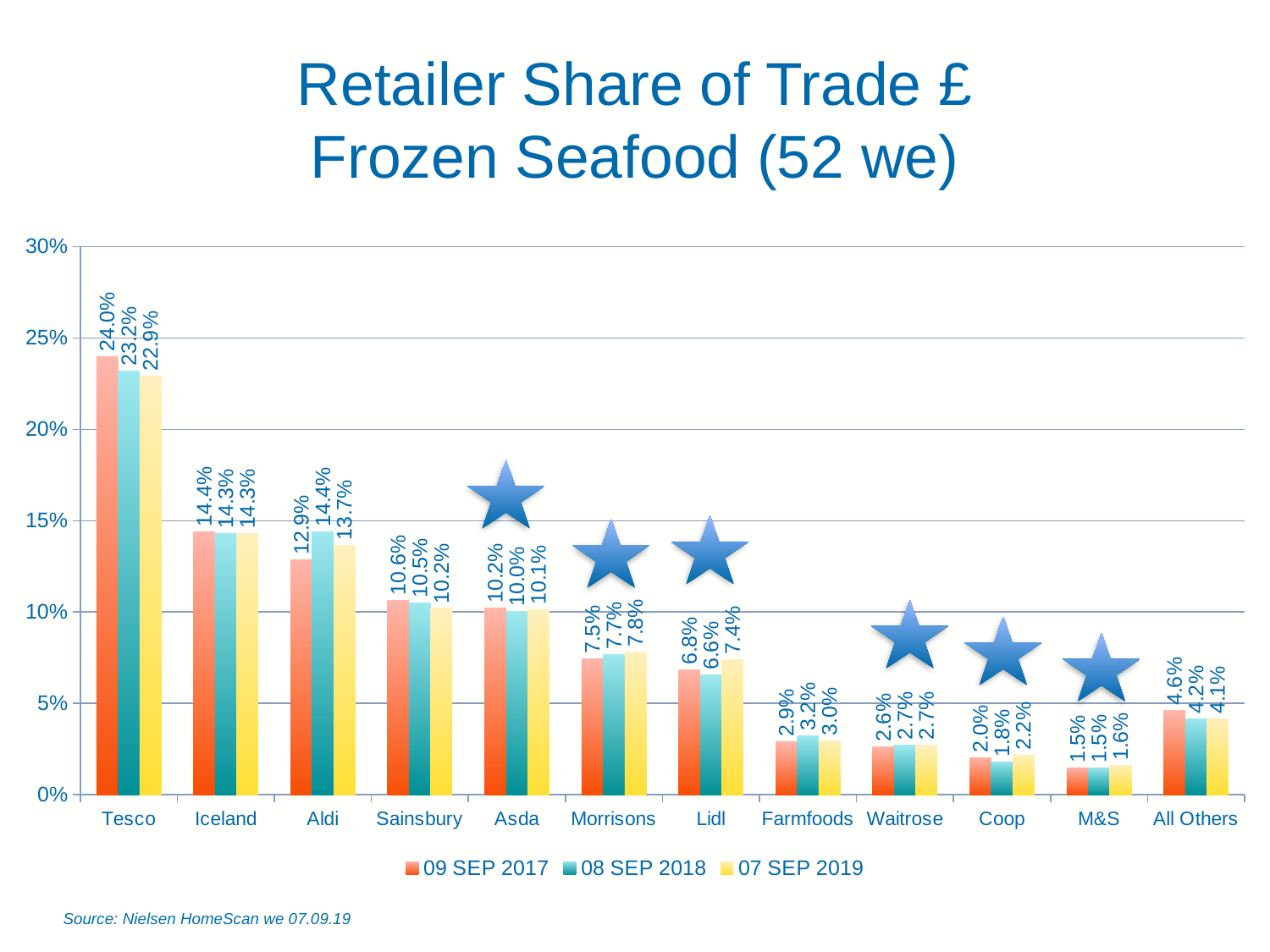
What is Tesco's share of trade for 07 SEP 2019? 22.9% What kind of chart is shown on the slide? Bar chart Did Tesco's share of trade rise or fall from 09 SEP 2017 to 07 SEP 2019? Fall How many retailer categories are shown on the x axis? 12 Which retailer has the highest share of trade in 07 SEP 2019? Tesco What is Aldi's share of trade for 08 SEP 2018? 14.4% What is the difference between Tesco's share in 09 SEP 2017 and 07 SEP 2019? 1.1% How many series does the legend list? 3 Is Sainsbury's share for 07 SEP 2019 greater or less than 15%? less Which retailer has the lowest share of trade in 09 SEP 2017? M&S Which is larger: Iceland's share in 07 SEP 2019 or Aldi's share in 07 SEP 2019? Iceland What is the value for Lidl in 09 SEP 2017? 6.8%